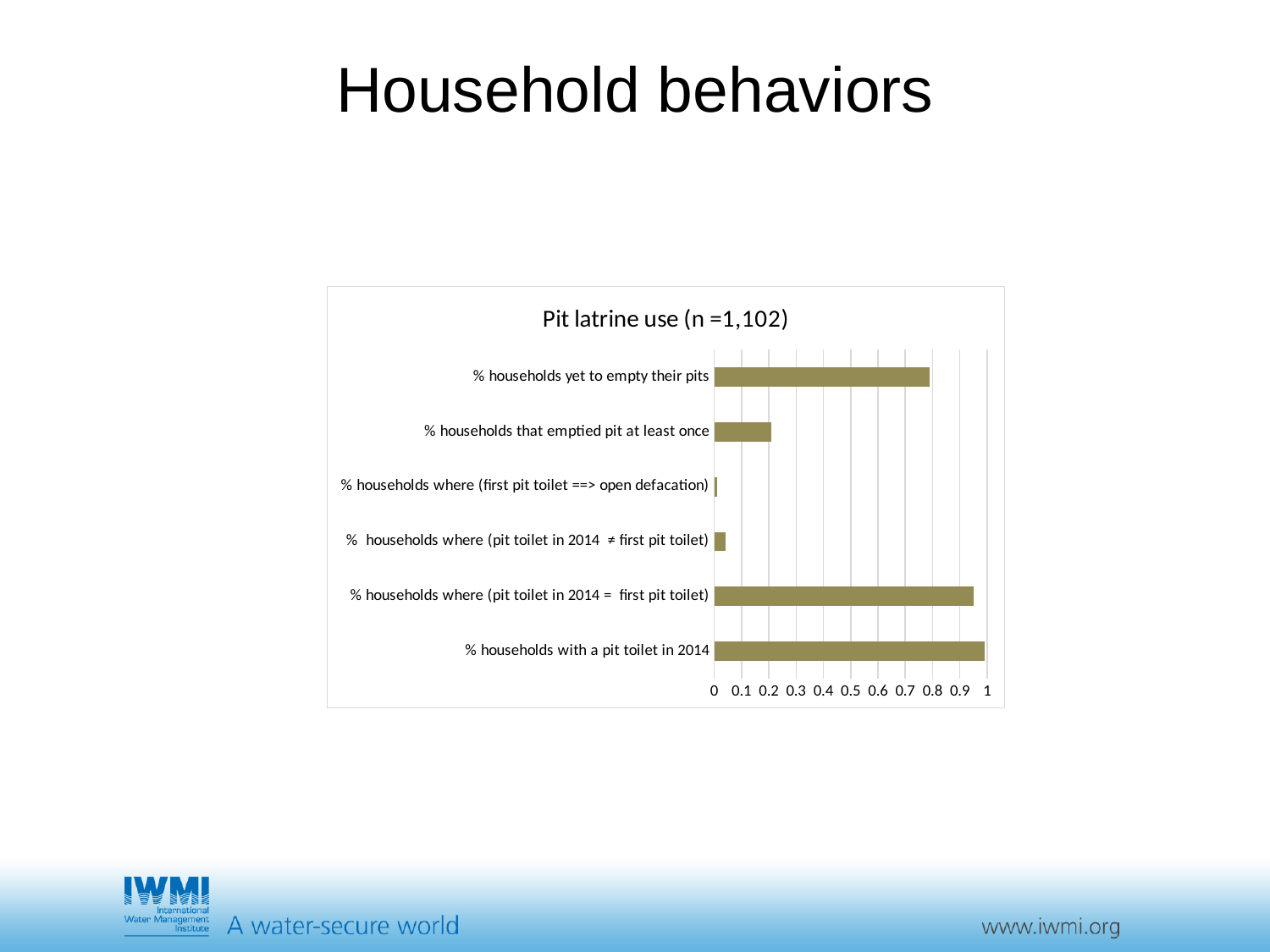
Which category has the lowest value? % households where (first pit toilet ==> open defacation) What is the maximum value shown on the horizontal axis? 1 What is the title of the chart? Pit latrine use (n =1,102) Which is larger: '% households yet to empty their pits' or '% households that emptied pit at least once'? % households yet to empty their pits Which category has the highest value? % households with a pit toilet in 2014 Is the value for '% households yet to empty their pits' greater or less than 0.7? greater Which is larger: '% households where (pit toilet in 2014 ≠ first pit toilet)' or '% households where (first pit toilet ==> open defacation)'? % households where (pit toilet in 2014 ≠ first pit toilet) Is the value for '% households where (pit toilet in 2014 = first pit toilet)' greater or less than 0.9? greater What kind of chart is shown on the slide? bar chart Is the value for '% households where (pit toilet in 2014 ≠ first pit toilet)' greater or less than 0.1? less How many categories are plotted in the chart? 6